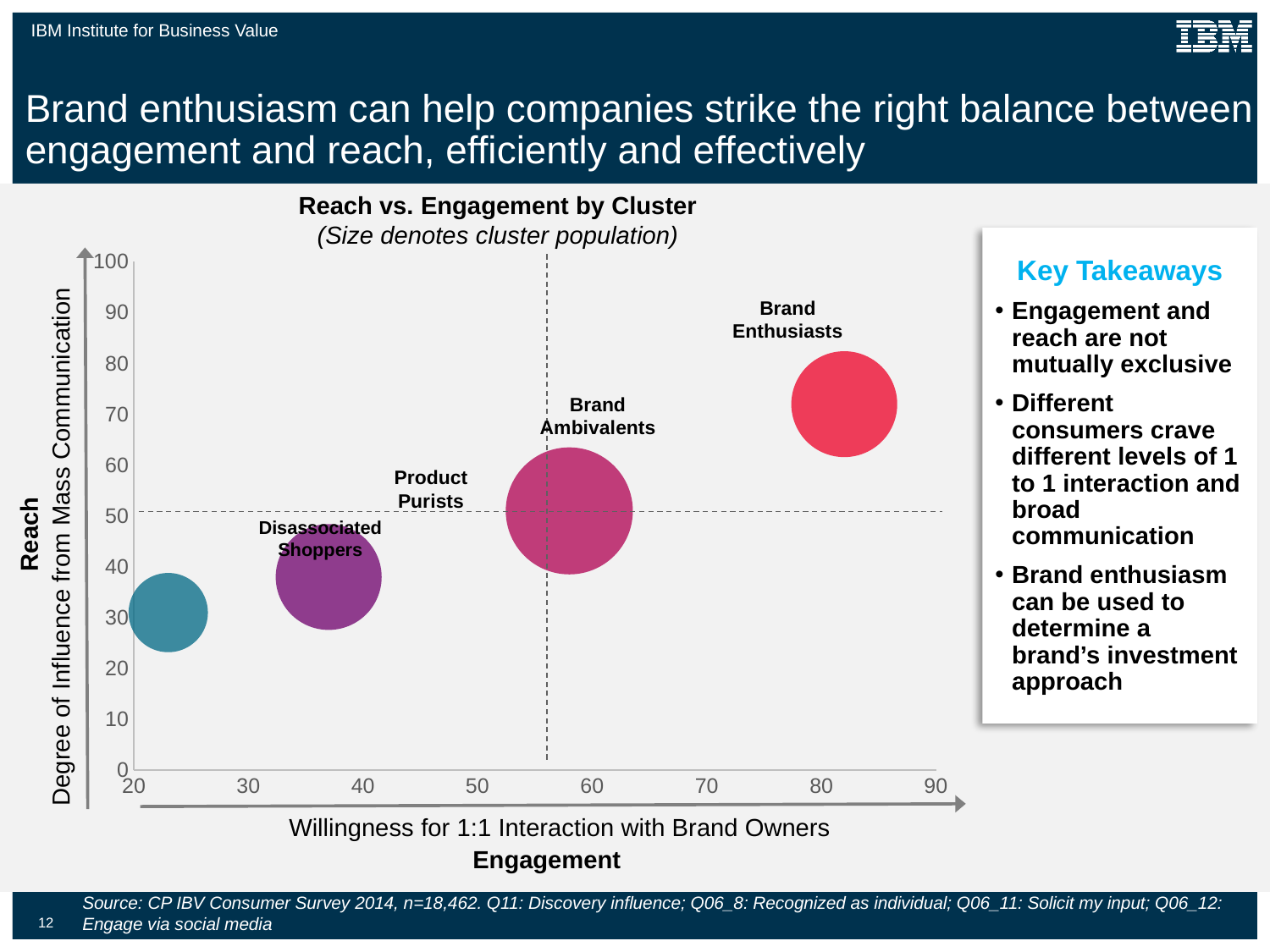
According to the chart subtitle, what does the size of each bubble denote? Cluster population Which cluster has the highest engagement (willingness for 1:1 interaction) on the chart? Brand Enthusiasts Which cluster is represented by the largest bubble on the chart? Brand Ambivalents Is the reach value for Brand Enthusiasts greater or less than 60? greater What is the title of the chart? Reach vs. Engagement by Cluster How many bubbles are plotted on the chart? 4 What is the maximum value shown on the Reach (vertical) axis? 100 Is the engagement value for Brand Enthusiasts greater or less than 70? greater What kind of chart is shown on the slide? Bubble chart Which cluster has the larger reach, Brand Enthusiasts or Brand Ambivalents? Brand Enthusiasts Is the engagement value for Brand Ambivalents greater or less than 50? greater Which cluster has the highest reach on the chart? Brand Enthusiasts